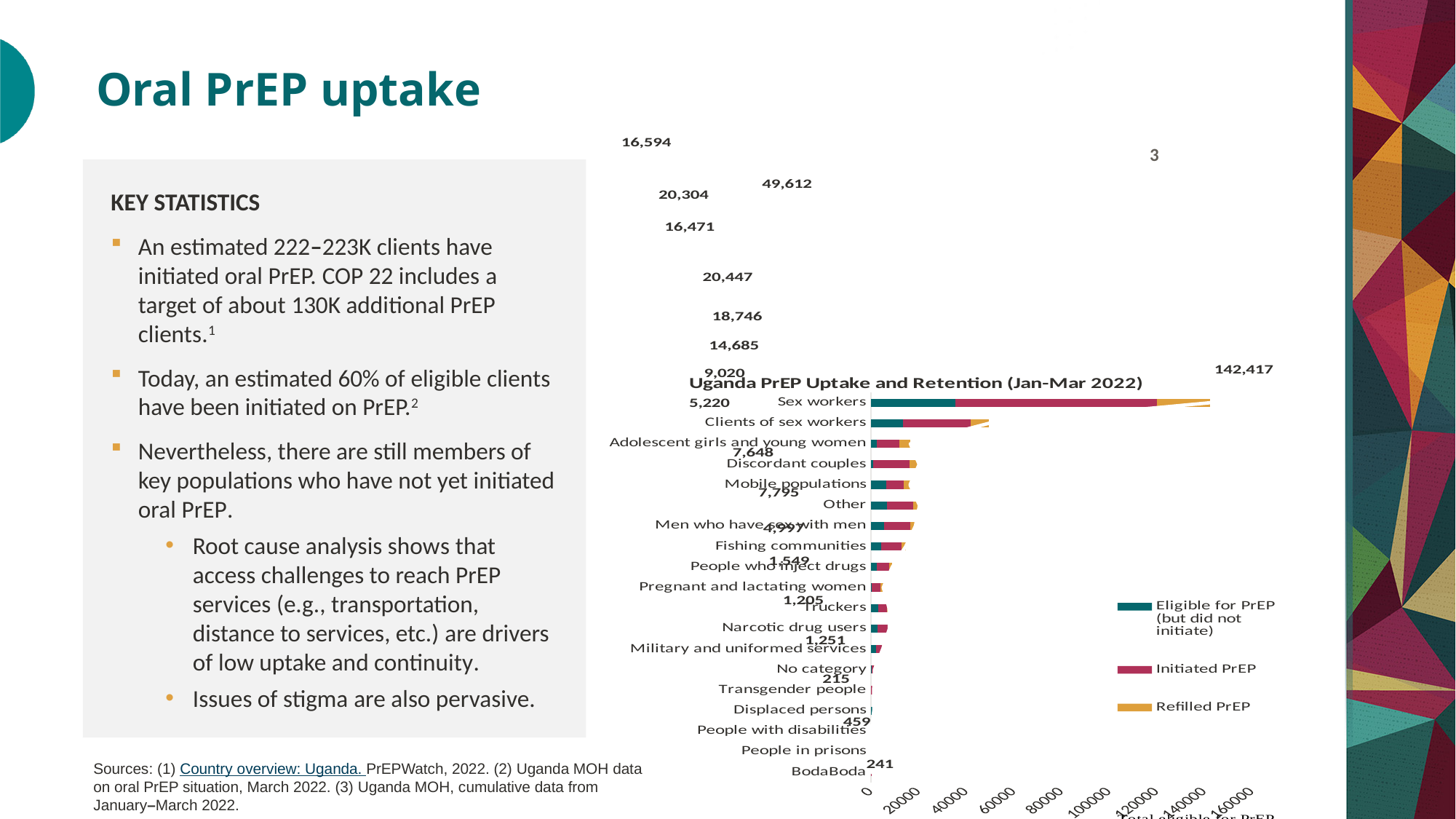
What is the title of the chart on the slide? Uganda PrEP Uptake and Retention (Jan-Mar 2022) How many population categories are plotted on the chart? 19 Which category has the second-longest bar on the chart? Clients of sex workers Which series are listed in the chart legend? Eligible for PrEP (but did not initiate), Initiated PrEP, Refilled PrEP Which has the longer bar: Sex workers or Discordant couples? Sex workers How many series does the chart legend list? 3 What kind of chart is shown on the slide? Stacked bar chart Which has the longer bar: Clients of sex workers or Adolescent girls and young women? Clients of sex workers Is the total bar length for Clients of sex workers greater or less than 80000? less Is the total bar length for Adolescent girls and young women greater or less than 40000? less Which category has the longest bar on the chart? Sex workers Is the total bar length for Sex workers greater or less than 120000? greater